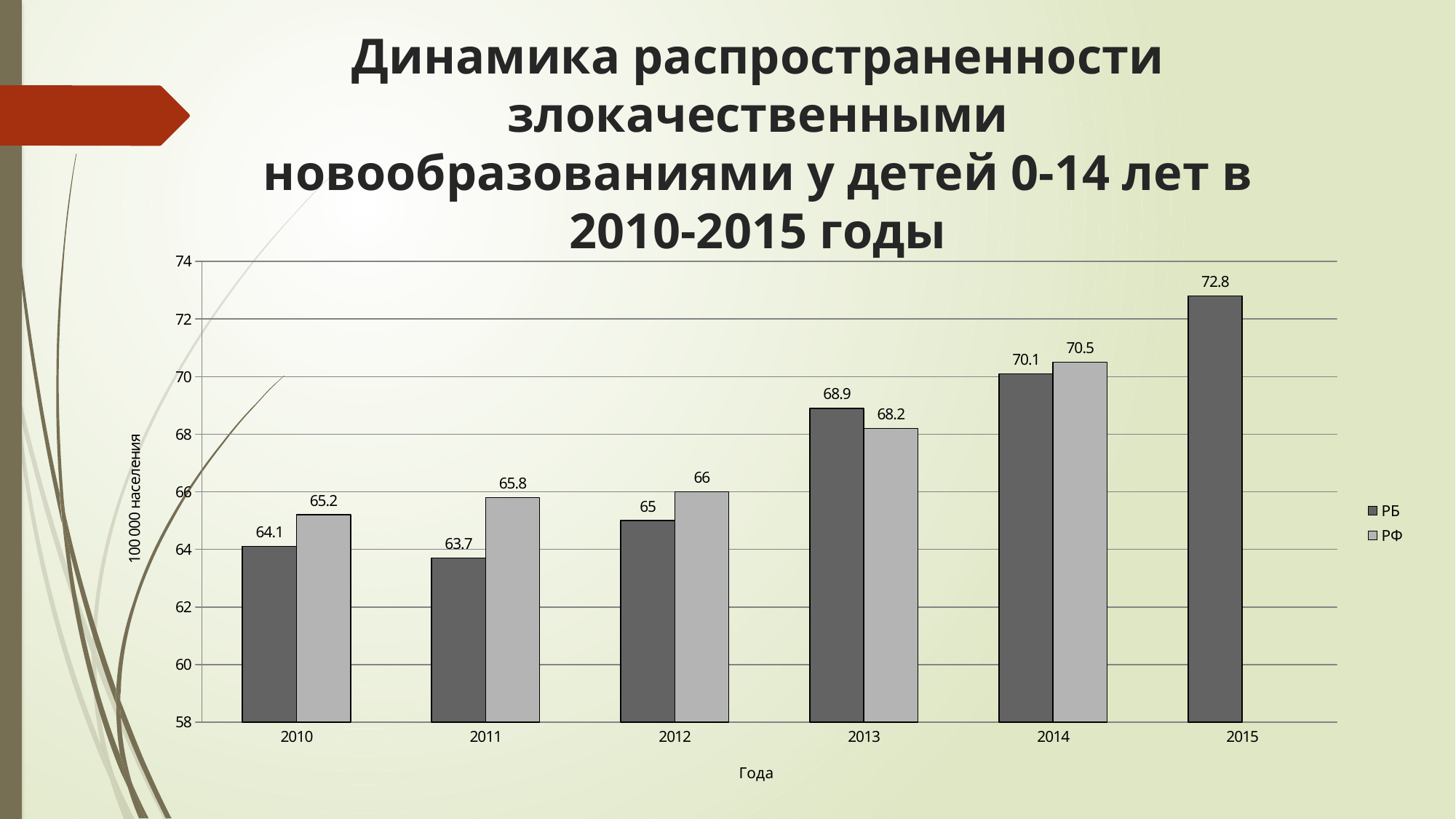
What kind of chart is shown on the slide? Bar chart What is the value for РБ in 2013? 68.9 How many series does the legend list? 2 What is the value for РФ in 2011? 65.8 In 2013, which series has the larger value, РБ or РФ? РБ What is the difference between the РФ and РБ values in 2011? 2.1 Which year has the highest value for РБ? 2015 Which year has the lowest value for РБ? 2011 What is the value for РБ in 2015? 72.8 Which year has the lowest value for РФ? 2010 How many years are shown on the x axis? 6 Do the РФ values generally rise or fall from 2010 to 2014? Rise